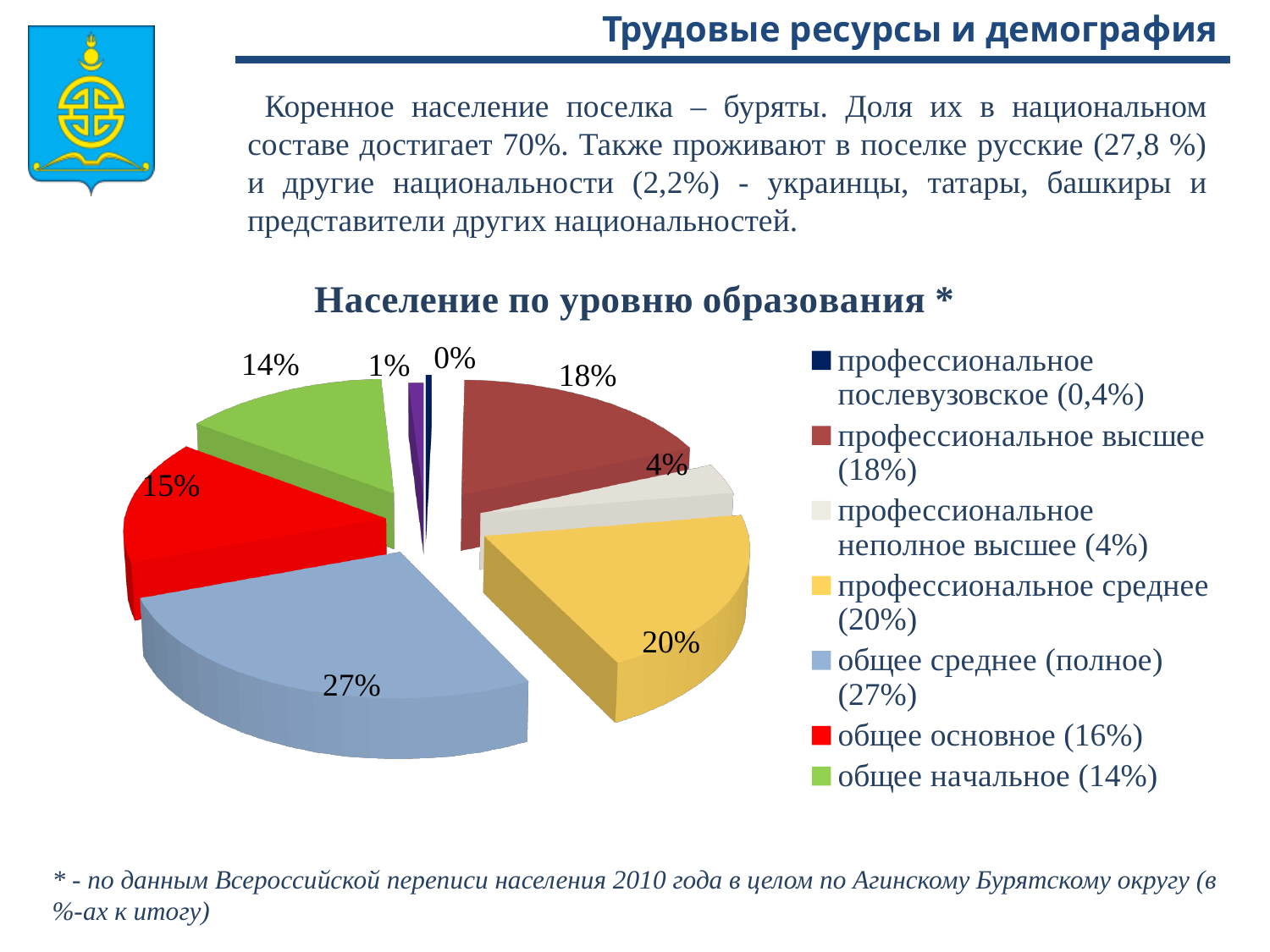
What share of the population has общее среднее (полное) education according to the pie chart? 27% By how many percentage points does the общее среднее (полное) slice exceed the профессиональное высшее slice? 9 What share of the population has профессиональное высшее education according to the pie chart? 18% Which education level has the largest slice in the pie chart? общее среднее (полное) Which education level has the smallest slice in the pie chart? профессиональное послевузовское What share of the population has профессиональное неполное высшее education according to the pie chart? 4% What is the title of the pie chart on the slide? Население по уровню образования * What kind of chart is shown under the title "Население по уровню образования *"? pie chart What share of the population has профессиональное среднее education according to the pie chart? 20% Which slice is larger in the pie chart: профессиональное высшее or профессиональное среднее? профессиональное среднее How many entries does the legend of the pie chart list? 7 What share of the population has общее начальное education according to the pie chart? 14%